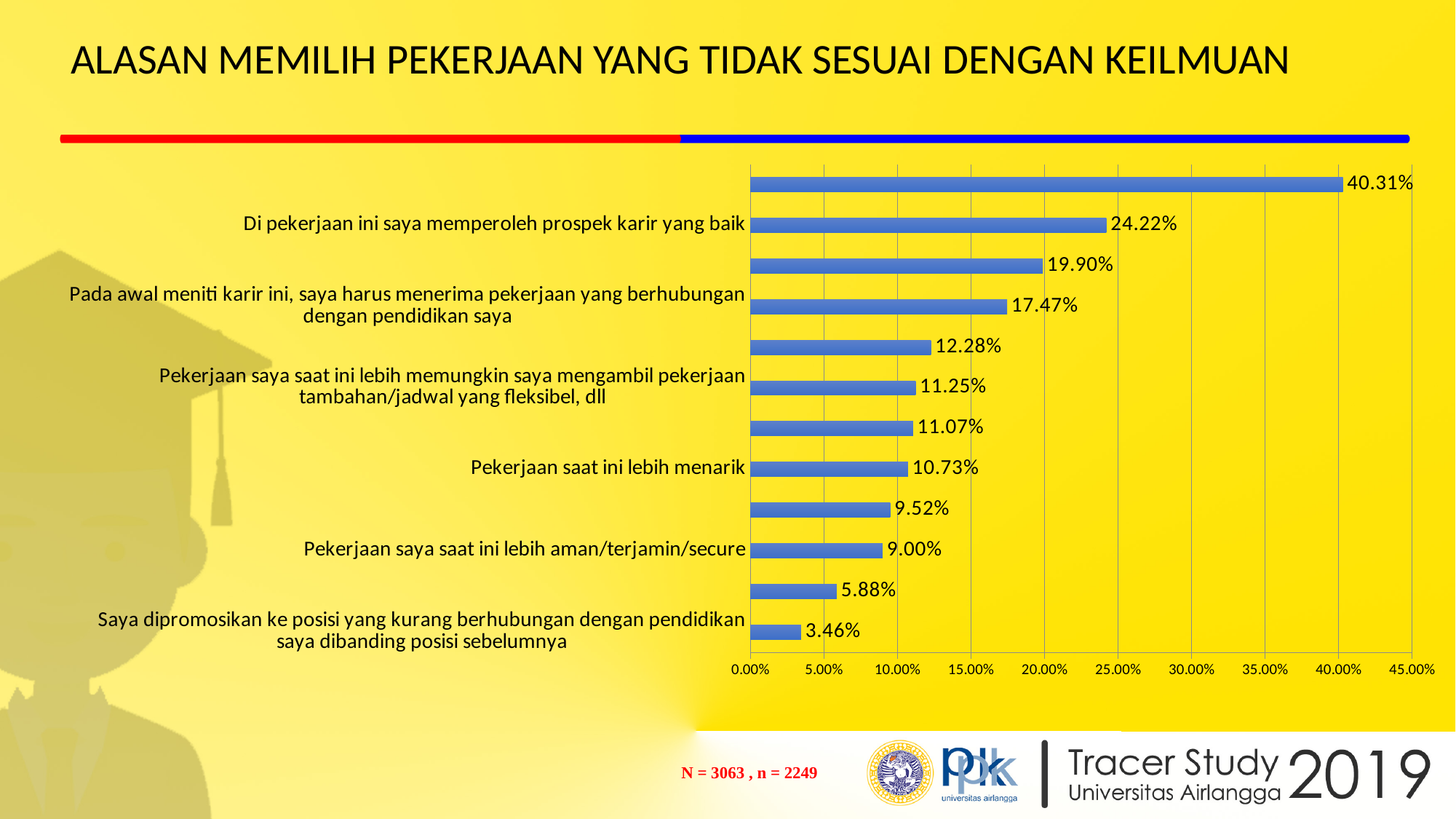
What is the value for "Pekerjaan saya saat ini lebih aman/terjamin/secure"? 9.00% What is the difference between the values for "Di pekerjaan ini saya memperoleh prospek karir yang baik" and "Pada awal meniti karir ini, saya harus menerima pekerjaan yang berhubungan dengan pendidikan saya"? 6.75% Which category has the lowest value in the chart? Saya dipromosikan ke posisi yang kurang berhubungan dengan pendidikan saya dibanding posisi sebelumnya What is the value for "Di pekerjaan ini saya memperoleh prospek karir yang baik"? 24.22% What is the value for "Pada awal meniti karir ini, saya harus menerima pekerjaan yang berhubungan dengan pendidikan saya"? 17.47% What is the title of the slide? ALASAN MEMILIH PEKERJAAN YANG TIDAK SESUAI DENGAN KEILMUAN Which is larger: the value for "Pekerjaan saat ini lebih menarik" or the value for "Pekerjaan saya saat ini lebih aman/terjamin/secure"? Pekerjaan saat ini lebih menarik What is the value for "Saya dipromosikan ke posisi yang kurang berhubungan dengan pendidikan saya dibanding posisi sebelumnya"? 3.46% How many bars are plotted in the chart? 12 What is the highest value shown in the chart? 40.31% What kind of chart is shown on the slide? bar chart What is the value for "Pekerjaan saat ini lebih menarik"? 10.73%